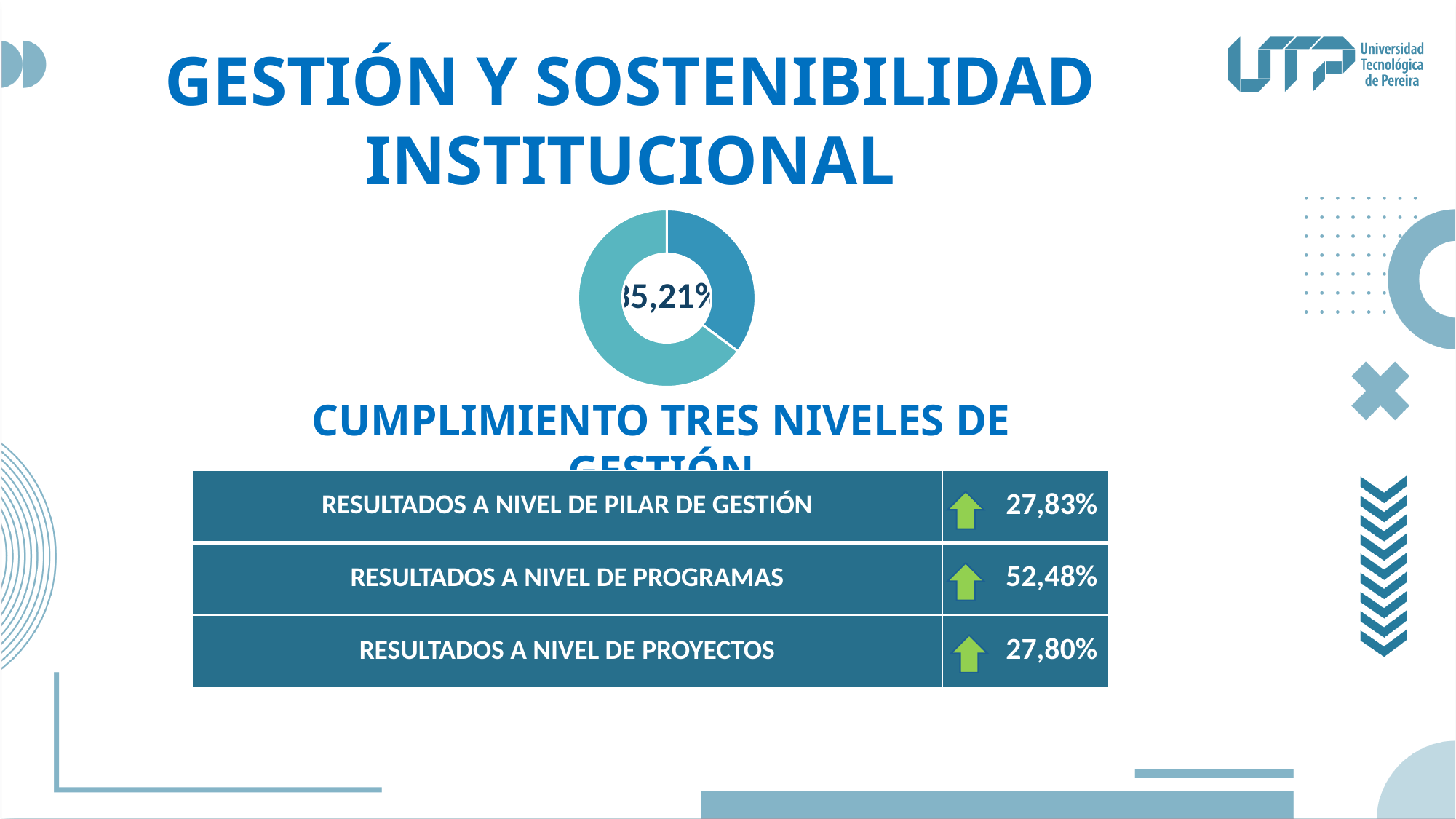
Which slice of the donut chart is larger, the dark blue one or the light teal one? the light teal one How many slices does the donut chart have? 2 In the table below the chart, what is the value for RESULTADOS A NIVEL DE PROGRAMAS? 52,48% What kind of chart is shown on the slide? donut (pie) chart Does the donut chart have a legend? No In the table below the chart, what is the difference between the value for PROGRAMAS and the value for PILAR DE GESTIÓN? 24,65% In the table below the chart, what is the value for RESULTADOS A NIVEL DE PROYECTOS? 27,80% Is the dark blue slice of the donut chart greater or less than 50% of the whole? less In the table below the chart, which level has the lowest value? RESULTADOS A NIVEL DE PROYECTOS In the table below the chart, what is the value for RESULTADOS A NIVEL DE PILAR DE GESTIÓN? 27,83% What heading appears directly below the donut chart? CUMPLIMIENTO TRES NIVELES DE GESTIÓN In the table below the chart, which level has the highest value? RESULTADOS A NIVEL DE PROGRAMAS